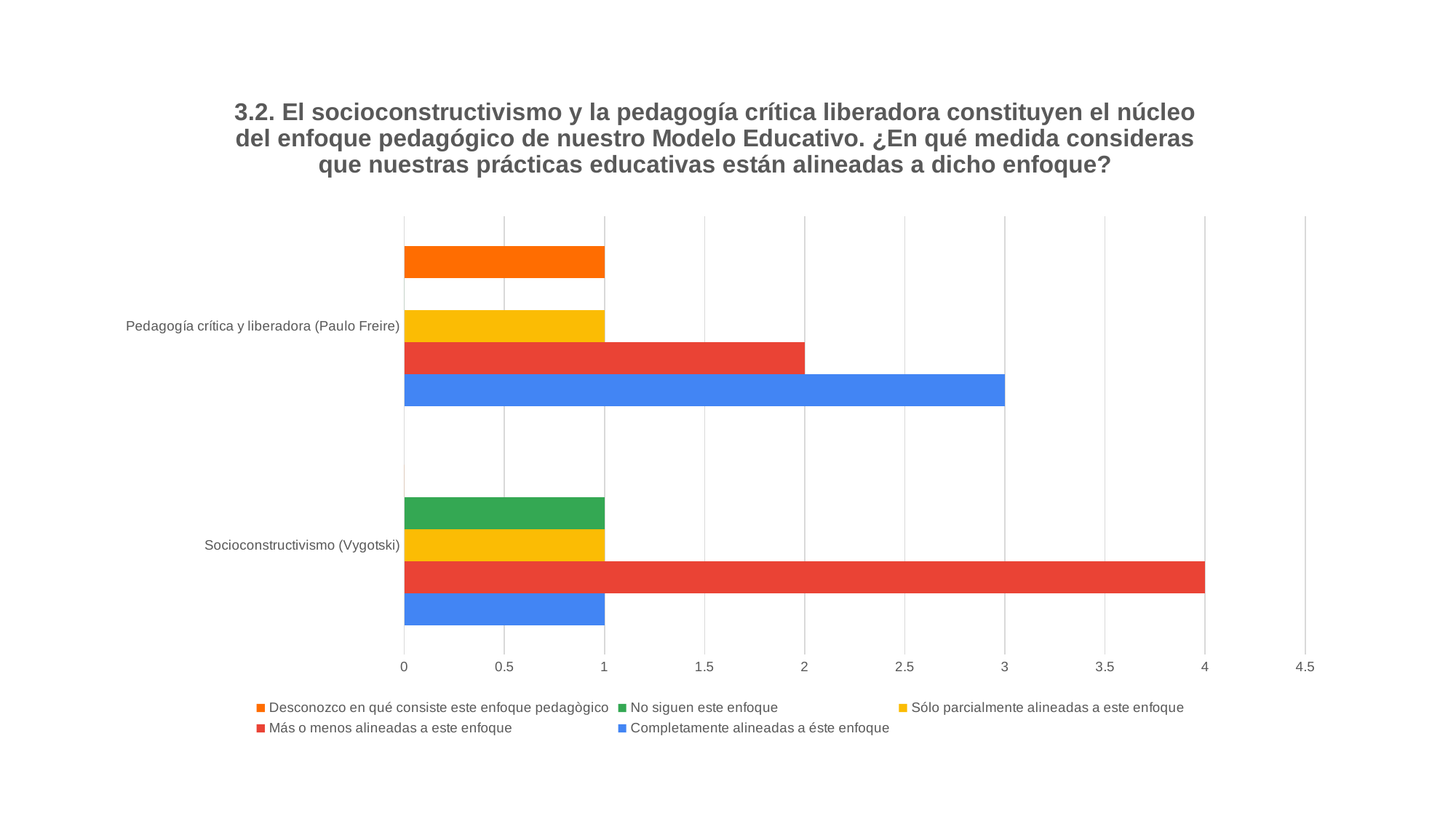
Which series has the highest value for Socioconstructivismo (Vygotski)? Más o menos alineadas a este enfoque How many series does the legend list? 5 What is the difference between the "Más o menos alineadas a este enfoque" values for Socioconstructivismo (Vygotski) and Pedagogía crítica y liberadora (Paulo Freire)? 2 Which is larger: "Completamente alineadas a éste enfoque" for Pedagogía crítica y liberadora (Paulo Freire) or for Socioconstructivismo (Vygotski)? Pedagogía crítica y liberadora (Paulo Freire) Which series has the highest value for Pedagogía crítica y liberadora (Paulo Freire)? Completamente alineadas a éste enfoque What is the value of "Completamente alineadas a éste enfoque" for Pedagogía crítica y liberadora (Paulo Freire)? 3 What kind of chart is shown on the slide? bar chart What is the value of "Completamente alineadas a éste enfoque" for Socioconstructivismo (Vygotski)? 1 What is the value of "Más o menos alineadas a este enfoque" for Socioconstructivismo (Vygotski)? 4 What is the value of "Más o menos alineadas a este enfoque" for Pedagogía crítica y liberadora (Paulo Freire)? 2 Which series appears only for Socioconstructivismo (Vygotski) and not for Pedagogía crítica y liberadora (Paulo Freire)? No siguen este enfoque How many categories are shown on the vertical axis? 2